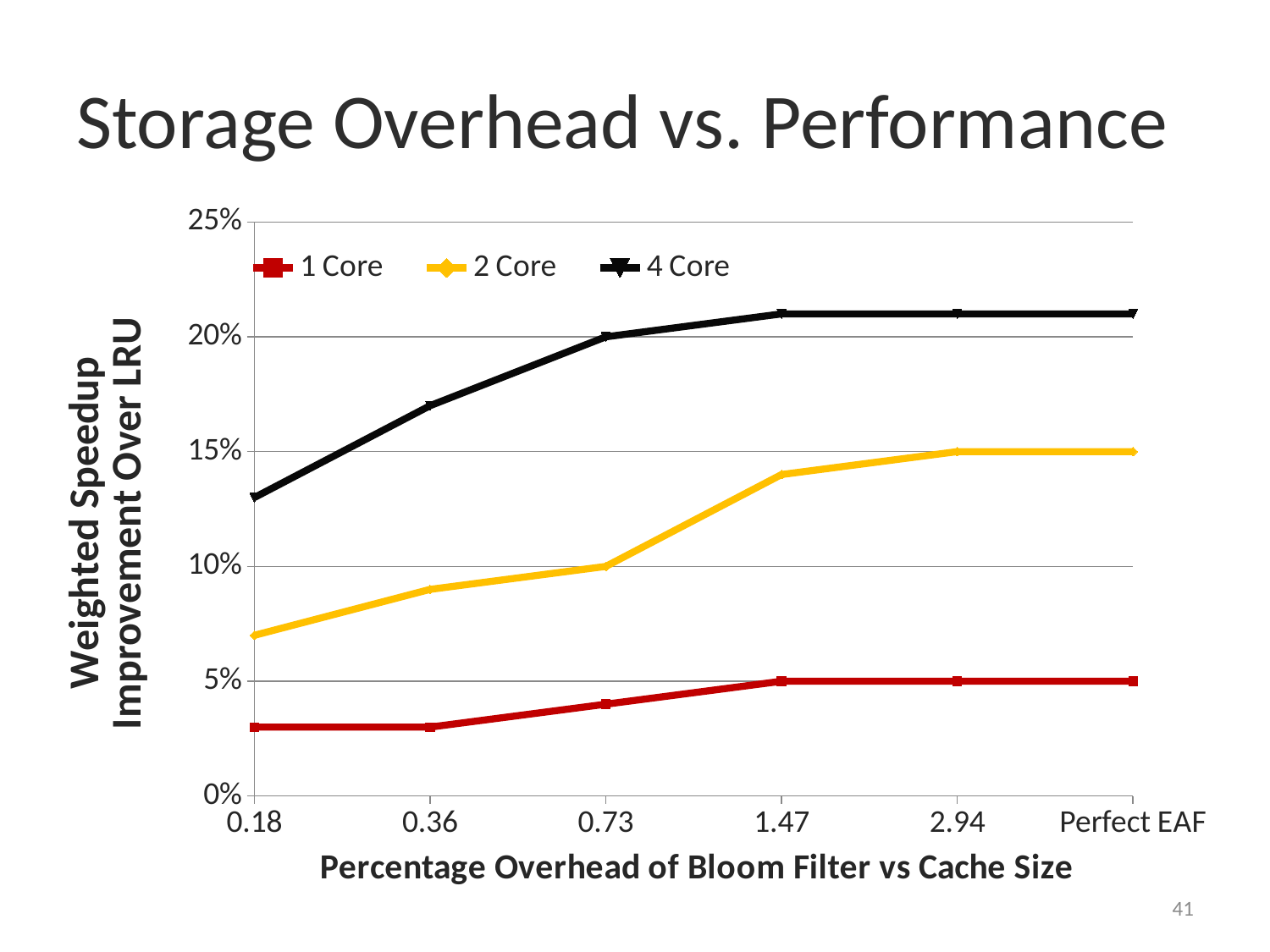
Is the value for 4 Core at 0.18 greater or less than 15%? less How many series does the legend list? 3 Is the value for 1 Core at 0.18 greater or less than 5%? less Which series has the highest values across the x axis? 4 Core What is the value for 4 Core at 0.73? 20% What is the value for 1 Core at Perfect EAF? 5% What is the value for 2 Core at 0.73? 10% Is the value for 4 Core at 1.47 greater or less than 20%? greater What kind of chart is shown on the slide? line chart Do the values for 4 Core rise or fall from 0.18 to 1.47? rise How many points are plotted along the x axis for each series? 6 What is the value for 2 Core at Perfect EAF? 15%